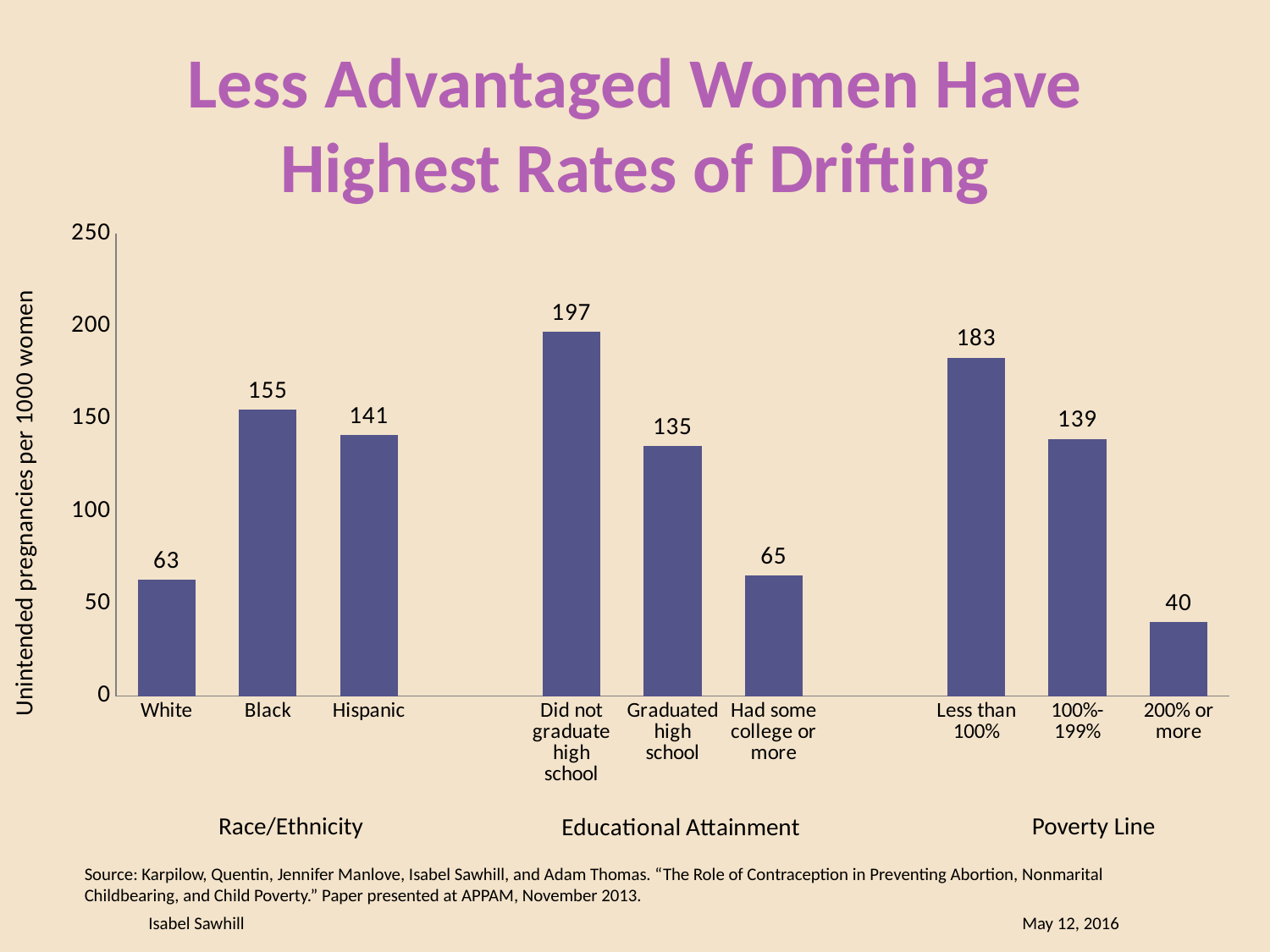
Which category has the highest value? Did not graduate high school What is the difference between the values for Less than 100% and 200% or more? 143 How many bars are shown in the chart? 9 What is the value for Did not graduate high school? 197 What kind of chart is shown on the slide? bar chart What is the value for 200% or more? 40 What is the value for Black? 155 Which category has the lowest value? 200% or more Is the value for Less than 100% greater or less than 150? greater What is the difference between the values for Black and White? 92 What is the label of the vertical axis? Unintended pregnancies per 1000 women Which is larger, the value for Hispanic or the value for Graduated high school? Hispanic